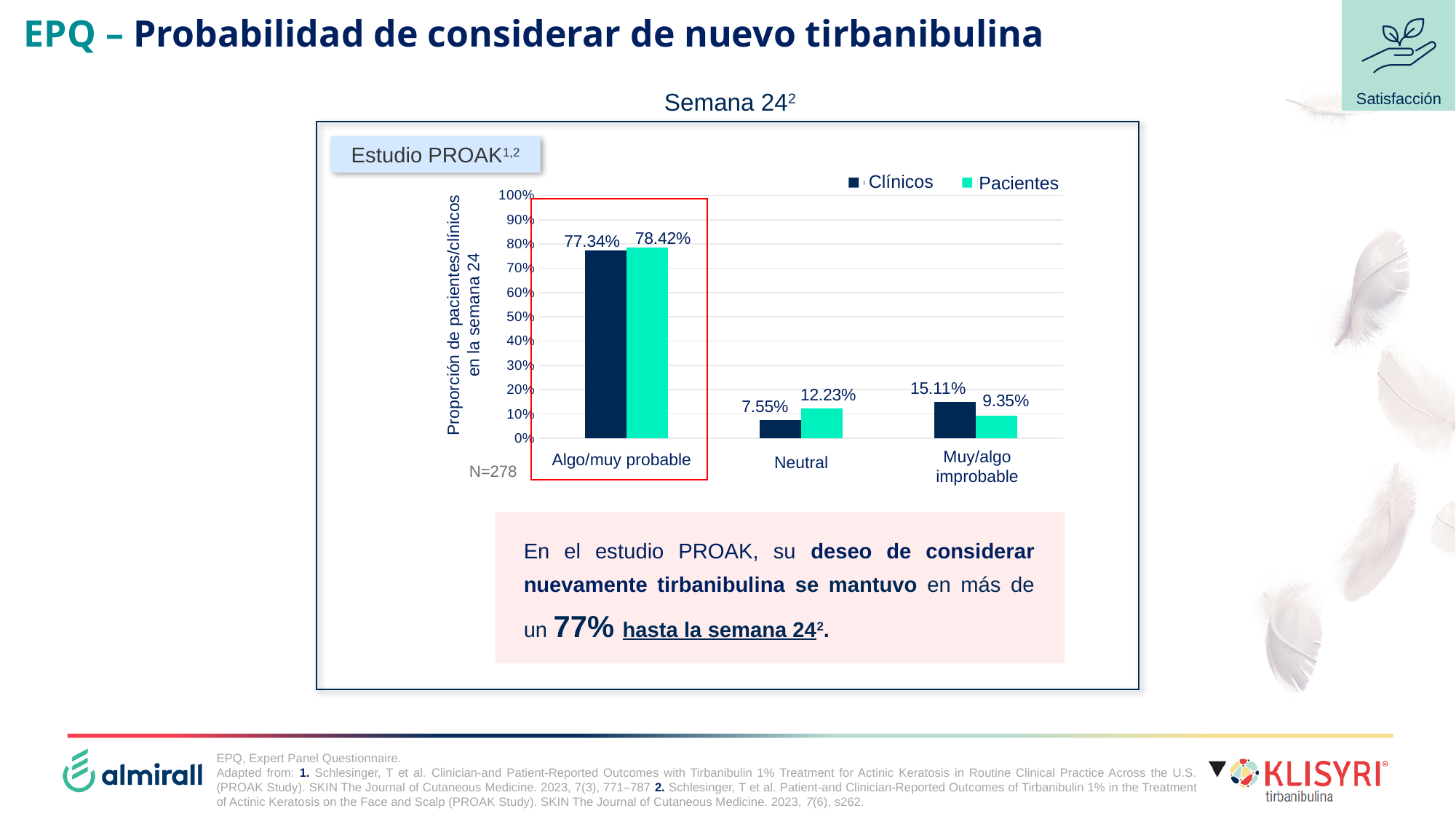
Which category has the highest value for Pacientes? Algo/muy probable Is the value for Clínicos in the Muy/algo improbable category greater or less than 20%? less How many series does the legend list? 2 How many categories are shown on the x axis? 3 Which category has the lowest value for Clínicos? Neutral What kind of chart is shown on the slide? Bar chart What is the value for Pacientes in the Algo/muy probable category? 78.42% What is the value for Clínicos in the Neutral category? 7.55% What is the value for Clínicos in the Algo/muy probable category? 77.34% In the Muy/algo improbable category, which series has the larger value, Clínicos or Pacientes? Clínicos What is the difference between the Pacientes and Clínicos values in the Neutral category? 4.68% What is the value for Pacientes in the Muy/algo improbable category? 9.35%